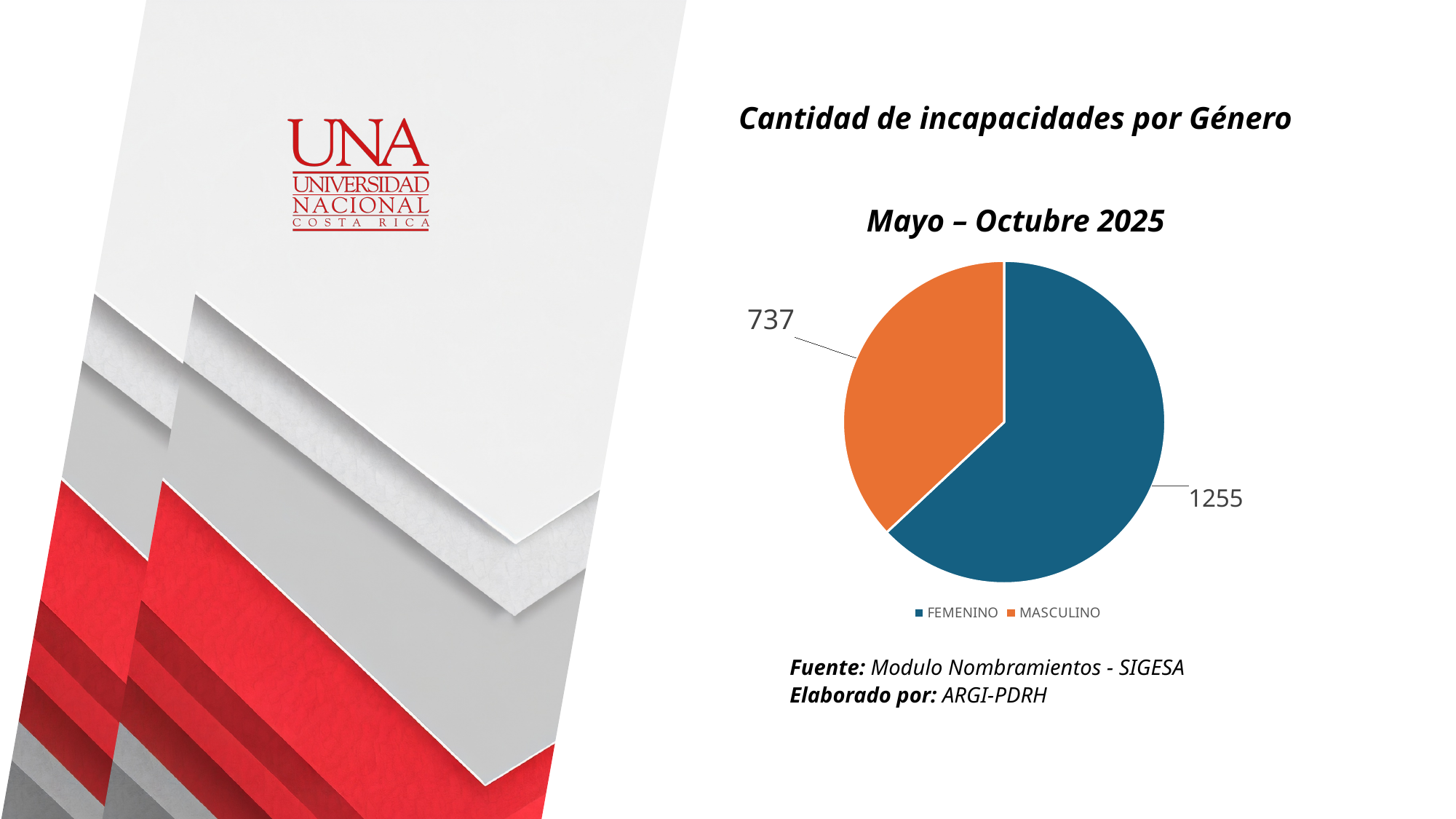
Which category has the largest slice in the pie chart? FEMENINO Which is larger, the value for FEMENINO or the value for MASCULINO? FEMENINO How many entries does the legend list? 2 What is the difference between the FEMENINO and MASCULINO values? 518 Which category has the smallest slice in the pie chart? MASCULINO What share of the pie does the FEMENINO slice represent? 63% What is the value for MASCULINO in the pie chart? 737 How many slices does the pie chart have? 2 What is the title shown directly above the pie chart? Mayo – Octubre 2025 What is the value for FEMENINO in the pie chart? 1255 What kind of chart is shown on the slide? Pie chart What is the total of all slices in the pie chart? 1992